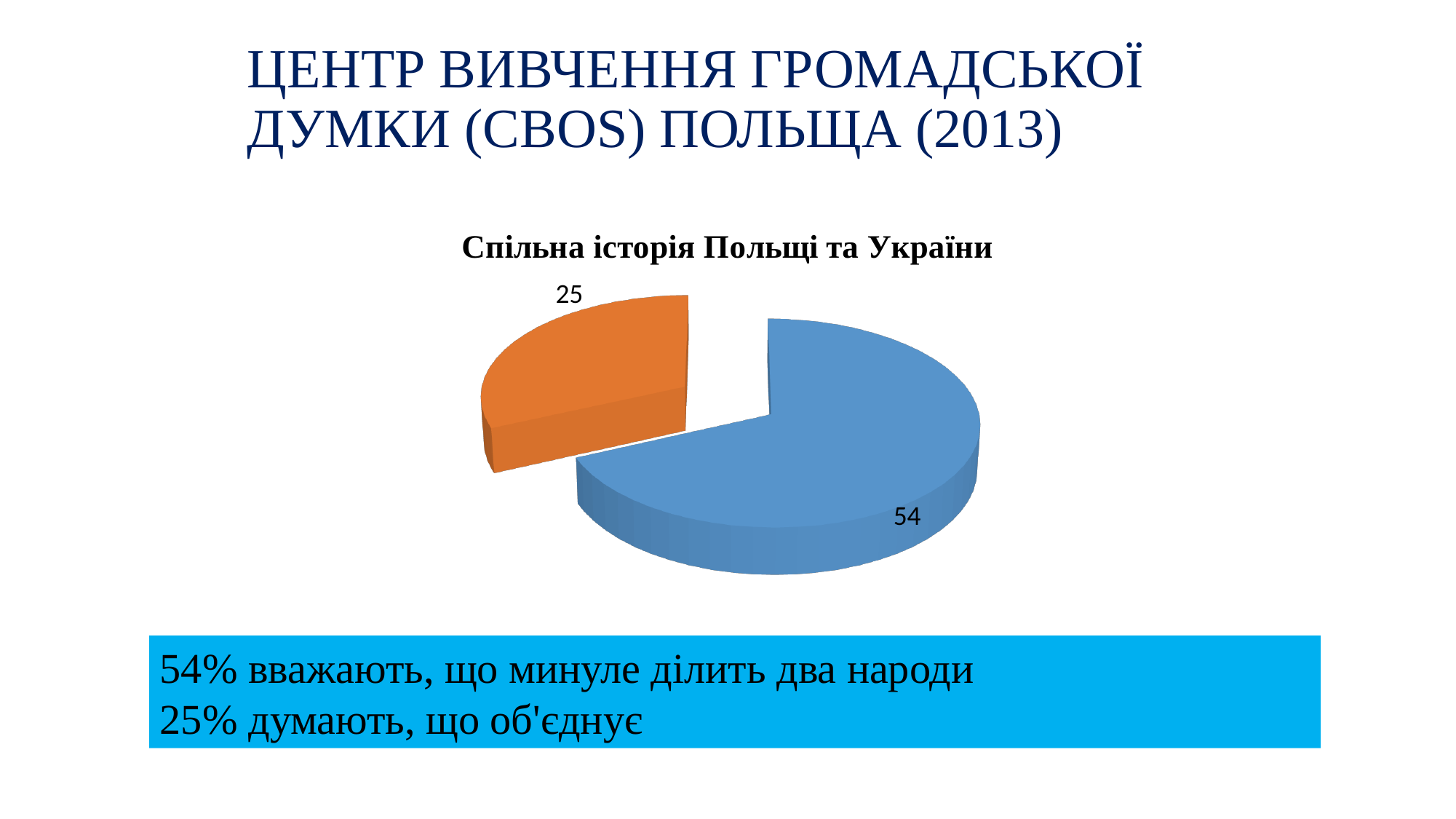
Which slice is larger, the blue one or the orange one? the blue one What is the value of the largest slice in the pie chart? 54 What is the difference between the two slice values in the pie chart? 29 What value is labelled on the orange slice of the pie chart? 25 What is the title of the chart? Спільна історія Польщі та України What colour is the slice labelled 54? blue What is the value of the smallest slice in the pie chart? 25 What value is labelled on the blue slice of the pie chart? 54 How many slices does the pie chart have? 2 What kind of chart is shown on the slide? pie chart